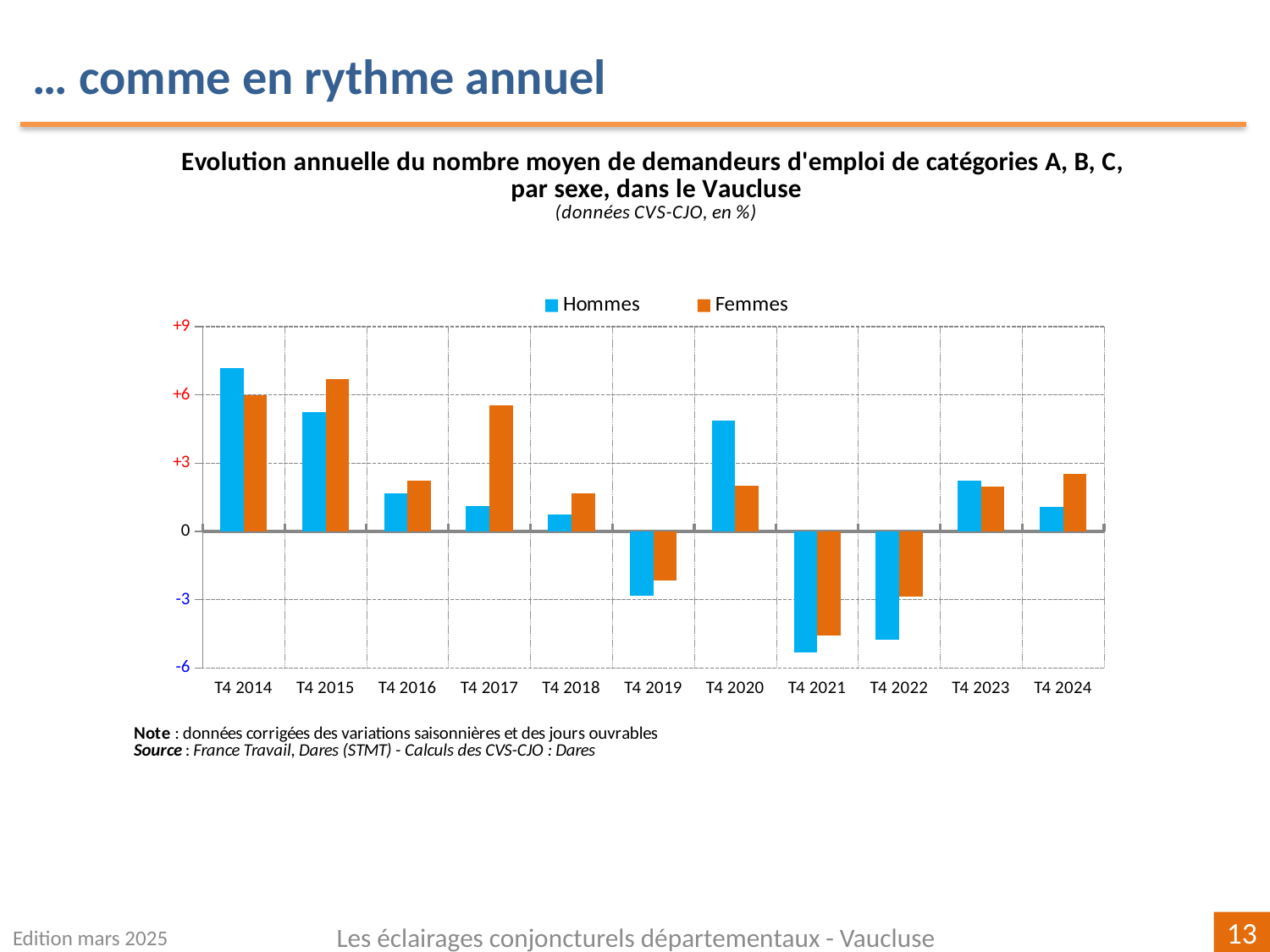
In which quarter is the Hommes value the lowest? T4 2021 In which quarter is the Femmes value the highest? T4 2015 Is the Femmes value for T4 2017 greater or less than +6? less In which quarter is the Femmes value the lowest? T4 2021 How many quarters (categories) are shown on the x axis? 11 How many series does the legend list? 2 In T4 2020, which series has the larger value, Hommes or Femmes? Hommes In T4 2017, which series has the larger value, Hommes or Femmes? Femmes What kind of chart is shown on the slide? bar chart Which colour represents the Hommes series in the legend? blue Is the Hommes value for T4 2014 greater or less than +6? greater In which quarter is the Hommes value the highest? T4 2014